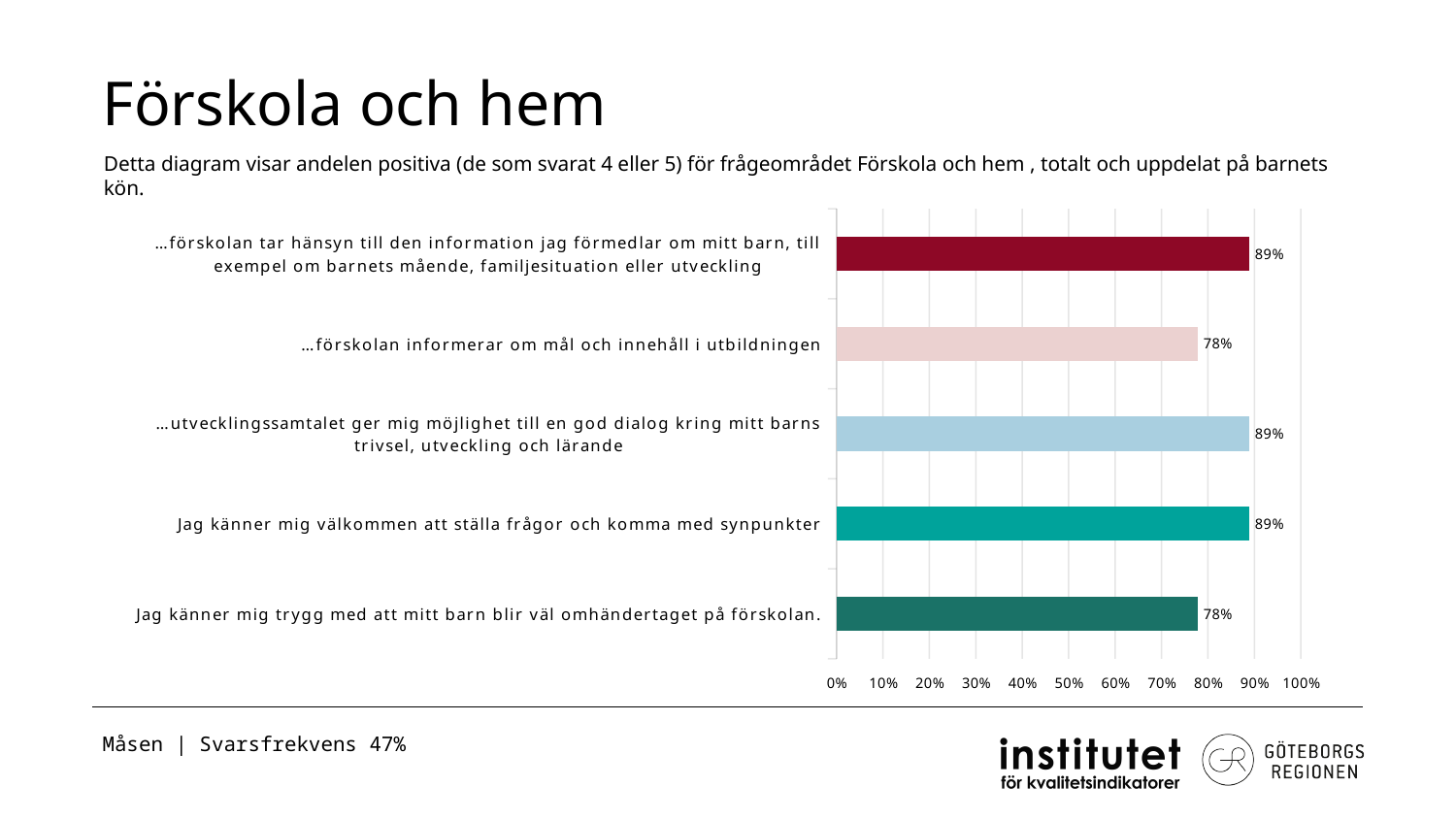
What is the highest value shown in the chart? 89% Is the value for "Jag känner mig trygg med att mitt barn blir väl omhändertaget på förskolan." greater or less than 80%? less Which is larger: the value for "…förskolan informerar om mål och innehåll i utbildningen" or the value for "…utvecklingssamtalet ger mig möjlighet till en god dialog kring mitt barns trivsel, utveckling och lärande"? …utvecklingssamtalet ger mig möjlighet till en god dialog kring mitt barns trivsel, utveckling och lärande What is the value for "…utvecklingssamtalet ger mig möjlighet till en god dialog kring mitt barns trivsel, utveckling och lärande"? 89% What is the value for "…förskolan tar hänsyn till den information jag förmedlar om mitt barn, till exempel om barnets mående, familjesituation eller utveckling"? 89% What is the difference between the value for "Jag känner mig välkommen att ställa frågor och komma med synpunkter" and the value for "Jag känner mig trygg med att mitt barn blir väl omhändertaget på förskolan."? 11% What kind of chart is shown on the slide? bar chart What is the value for "…förskolan informerar om mål och innehåll i utbildningen"? 78% What is the value for "Jag känner mig välkommen att ställa frågor och komma med synpunkter"? 89% How many categories (statements) are plotted in the chart? 5 What is the title of the slide containing the chart? Förskola och hem What is the value for "Jag känner mig trygg med att mitt barn blir väl omhändertaget på förskolan."? 78%